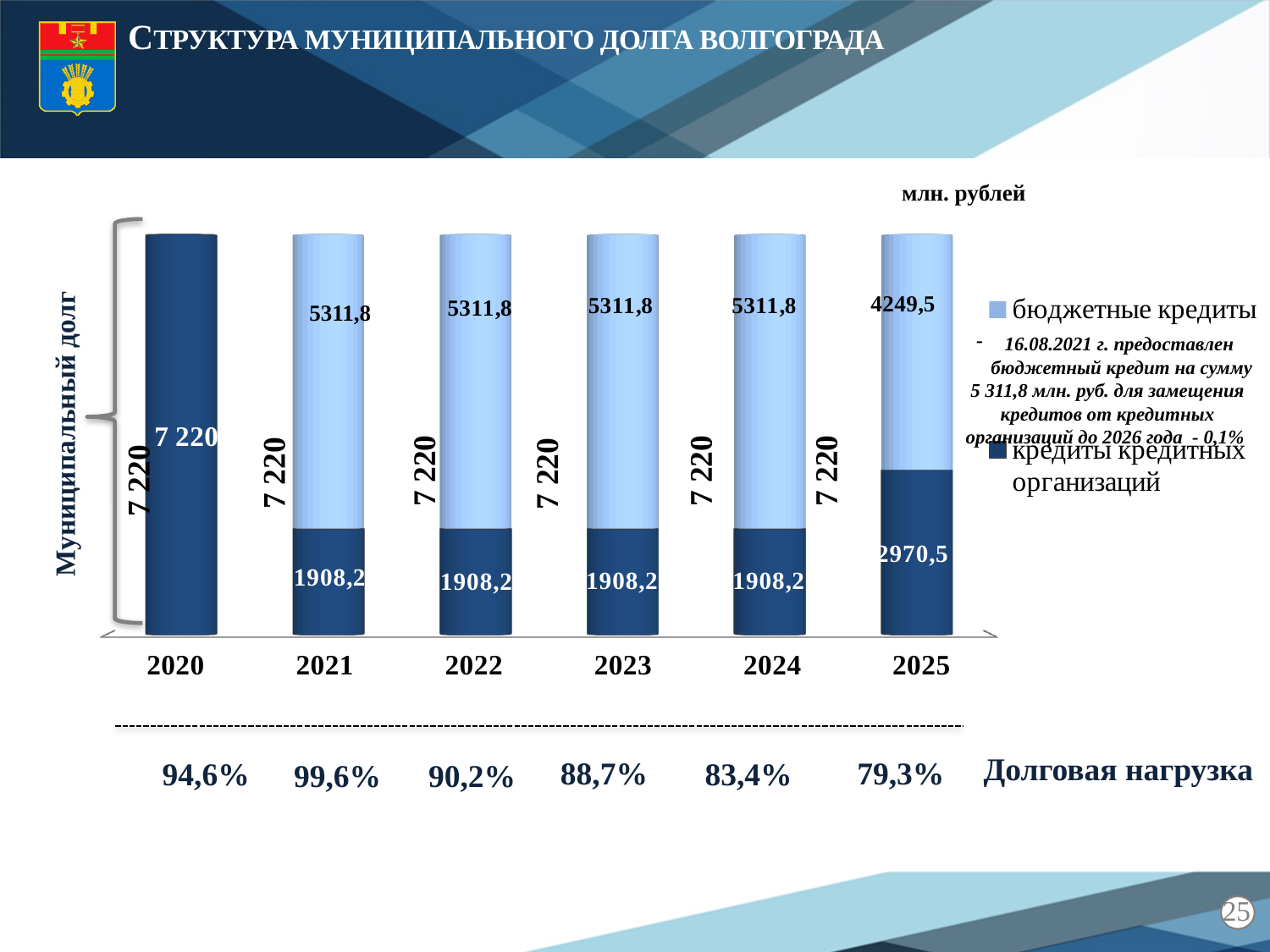
What is the total of the stacked bar for 2023? 7 220 In which year is the value of кредиты кредитных организаций highest? 2020 Which is larger in 2025: бюджетные кредиты or кредиты кредитных организаций? бюджетные кредиты What is the value of кредиты кредитных организаций for 2020? 7 220 How many series does the legend list? 2 In which year is the value of бюджетные кредиты lowest among the years where it is shown? 2025 What is the difference between бюджетные кредиты and кредиты кредитных организаций in 2022? 3403,6 What kind of chart is shown on the slide? stacked bar chart What is the value of кредиты кредитных организаций for 2025? 2970,5 What is the value of бюджетные кредиты for 2025? 4249,5 How many years are shown on the x axis of the chart? 6 What is the value of бюджетные кредиты for 2021? 5311,8